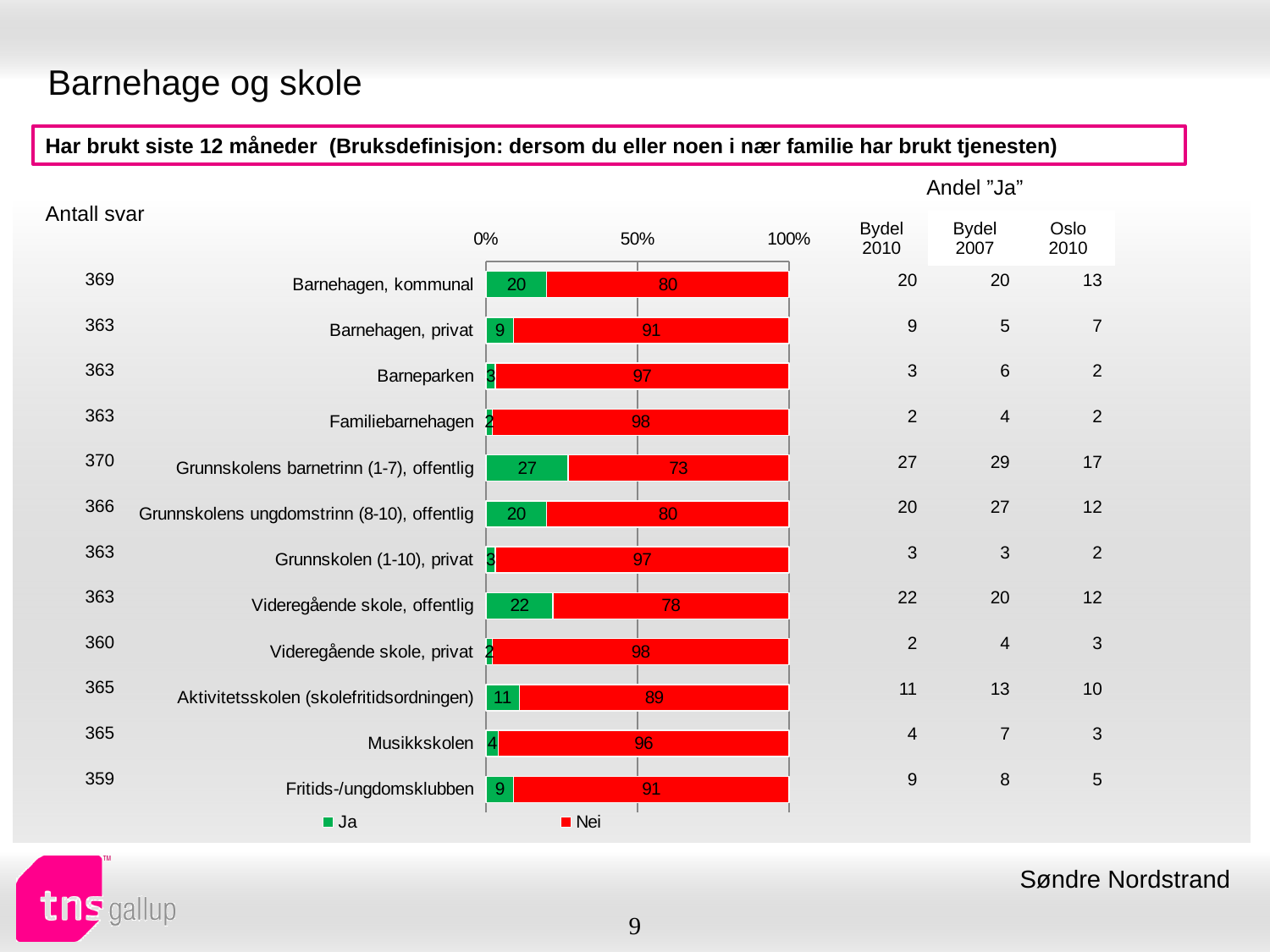
What is the Ja value for Barnehagen, kommunal? 20 How many series does the chart legend list? 2 What are the two series named in the chart legend? Ja and Nei How many categories are plotted in the chart? 12 Which category has the lowest Nei value? Grunnskolens barnetrinn (1-7), offentlig Which category has the highest Ja value? Grunnskolens barnetrinn (1-7), offentlig What is the total of the stacked bar for Fritids-/ungdomsklubben (Ja plus Nei)? 100 What is the difference between the Ja value for Grunnskolens barnetrinn (1-7), offentlig and the Ja value for Videregående skole, offentlig? 5 What kind of chart is shown on the slide? bar chart Which has the larger Ja value, Aktivitetsskolen (skolefritidsordningen) or Musikkskolen? Aktivitetsskolen (skolefritidsordningen) What is the Nei value for Aktivitetsskolen (skolefritidsordningen)? 89 What is the Ja value for Videregående skole, offentlig? 22